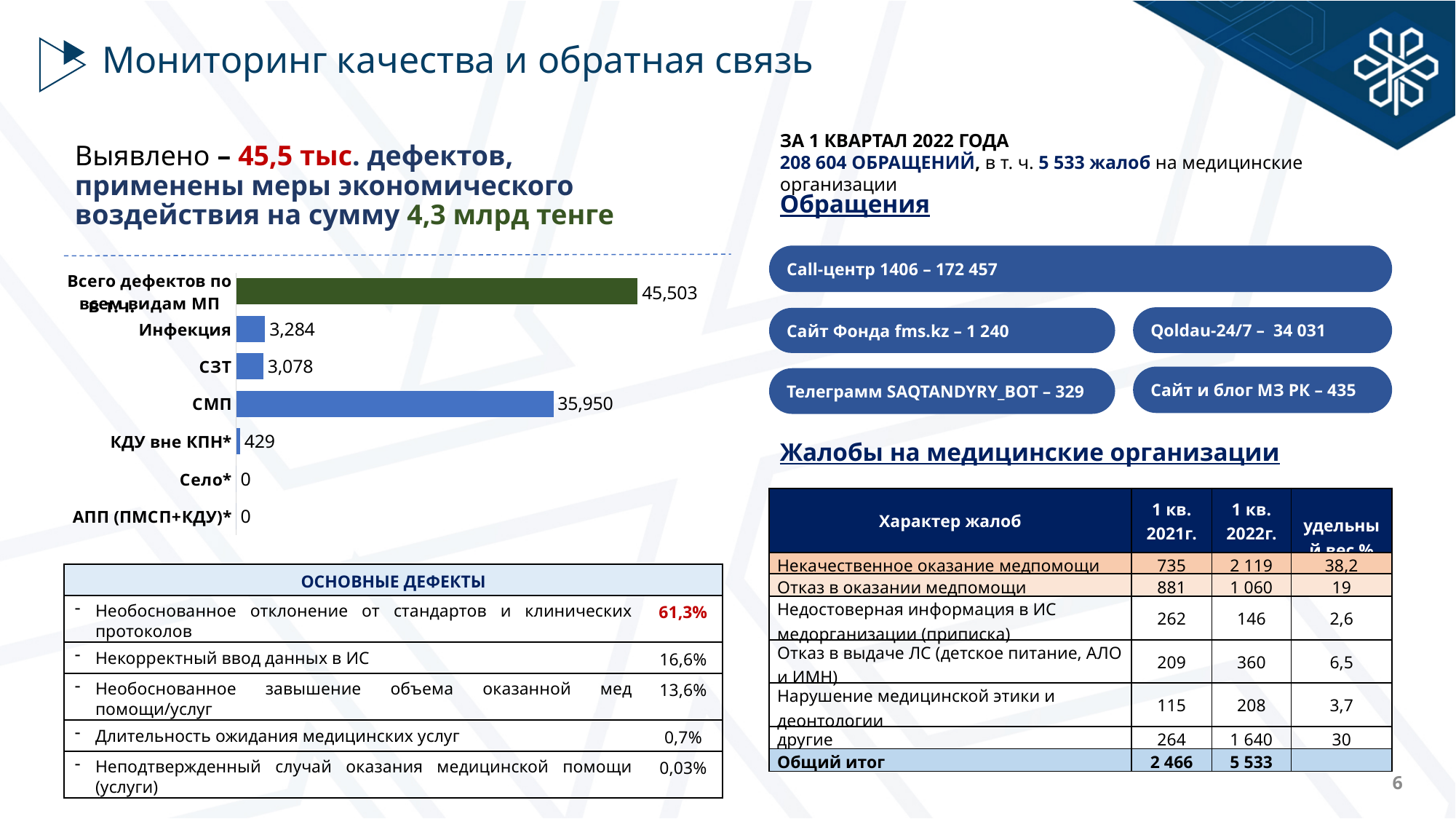
What colour is the bar for Всего дефектов по всем видам МП in the bar chart? Dark green What is the value for СМП in the bar chart? 35,950 What is the value for СЗТ in the bar chart? 3,078 What is the value for Всего дефектов по всем видам МП in the bar chart? 45,503 What is the value for КДУ вне КПН* in the bar chart? 429 What is the value for Инфекция in the bar chart? 3,284 Which is larger in the bar chart, Инфекция or СЗТ? Инфекция What is the difference between the values for СМП and Инфекция in the bar chart? 32,666 What type of chart is shown on the slide? Bar chart Which category has the highest value in the bar chart? Всего дефектов по всем видам МП Which categories in the bar chart have a value of 0? Село* and АПП (ПМСП+КДУ)* How many categories are shown in the bar chart? 7